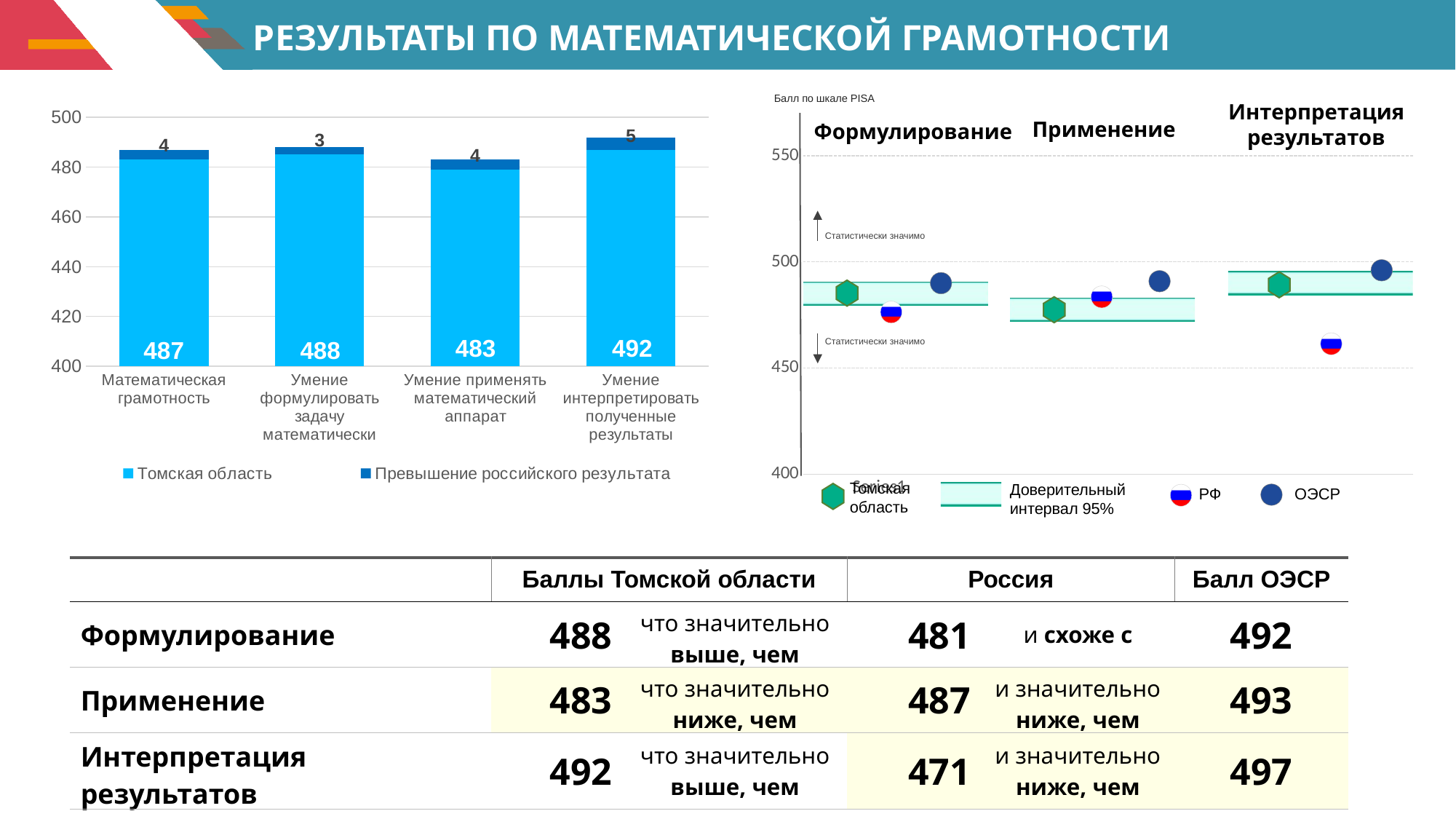
In the left bar chart, which category has the lowest Томская область value? Умение применять математический аппарат In the left bar chart, what is the Превышение российского результата value for Умение формулировать задачу математически? 3 What kind of chart is the chart on the left of the slide? Bar chart In the left bar chart, how many series does the legend list? 2 In the left bar chart, which category has the highest Томская область value? Умение интерпретировать полученные результаты In the right chart (Балл по шкале PISA), is the ОЭСР value for Интерпретация результатов greater or less than 450? greater In the left bar chart, what is the difference between the Томская область values for Умение интерпретировать полученные результаты and Умение применять математический аппарат? 9 In the left bar chart, what is the total of the stacked bar for Умение применять математический аппарат? 483 In the left bar chart, what is the Томская область value for Математическая грамотность? 487 In the left bar chart, what is the Томская область value for Умение интерпретировать полученные результаты? 492 In the right chart (Балл по шкале PISA), how many categories are shown along the x axis? 3 In the right chart (Балл по шкале PISA), is the РФ value for Интерпретация результатов greater or less than 500? less